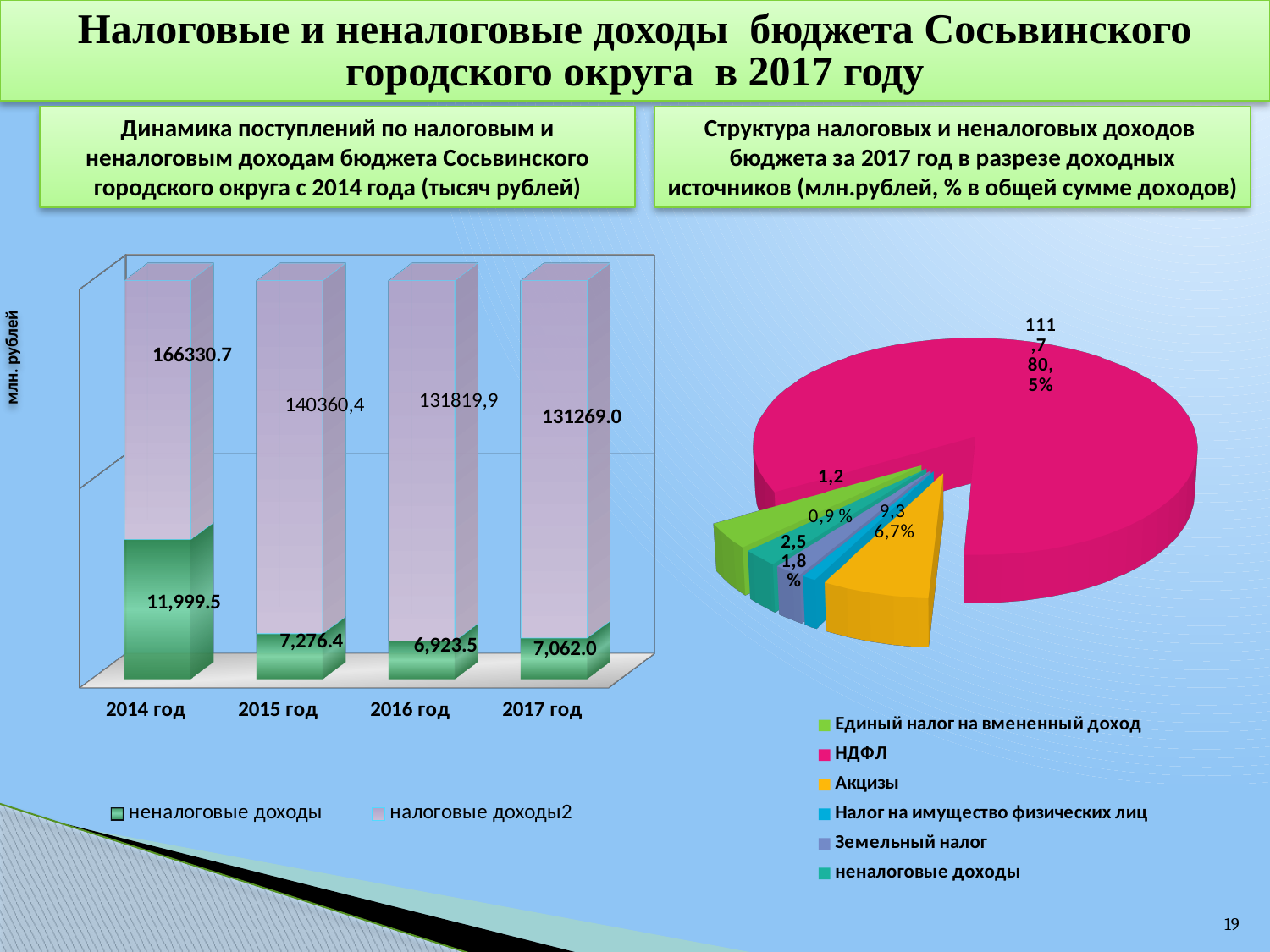
On the left bar chart, which year has the lowest value for налоговые доходы2? 2017 год On the right pie chart, how many categories does the legend list? 6 On the left bar chart, what is the value of неналоговые доходы for 2017 год? 7,062.0 On the left bar chart, does the value of налоговые доходы2 rise or fall from 2014 год to 2017 год? fall On the left bar chart, how many series does the legend list? 2 On the left bar chart, how many years are shown on the x axis? 4 On the left bar chart, which is larger: неналоговые доходы in 2015 год or in 2016 год? 2015 год On the right pie chart, what share of total income does НДФЛ account for? 80,5% On the left bar chart, which year has the highest value for неналоговые доходы? 2014 год On the left bar chart, what is the value of налоговые доходы2 for 2016 год? 131819,9 What kind of chart is shown on the right side of the slide? pie chart On the left bar chart, what is the value of налоговые доходы2 for 2014 год? 166330.7